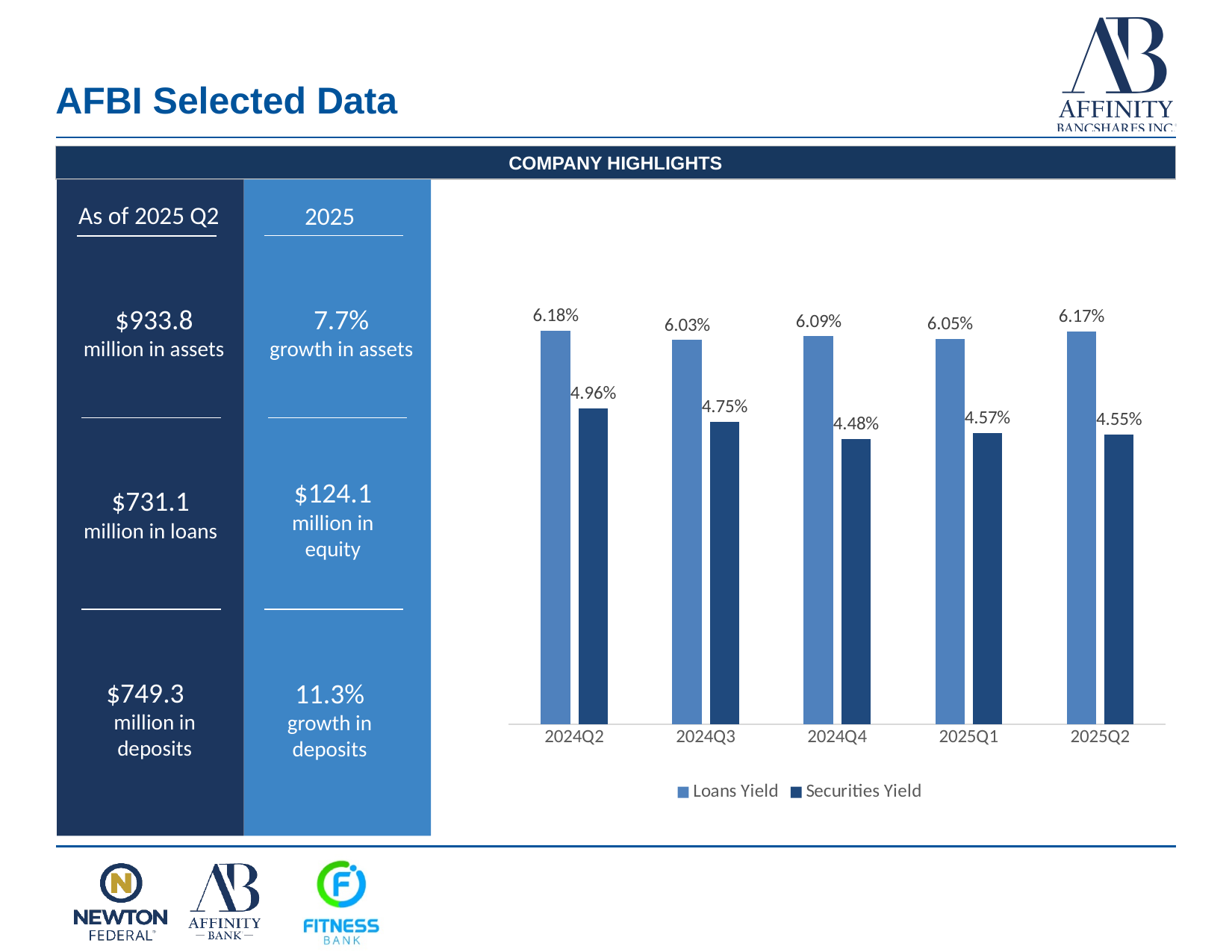
How many series does the chart legend list? 2 Which quarter has the lowest Loans Yield? 2024Q3 What is the difference between the Loans Yield and the Securities Yield in 2025Q2? 1.62% Which quarter has the highest Loans Yield? 2024Q2 What kind of chart is shown on the slide? Bar chart What is the Securities Yield for 2024Q4? 4.48% What is the Loans Yield for 2024Q2? 6.18% How many quarters are shown on the x axis of the chart? 5 Is the Securities Yield higher in 2024Q2 or in 2024Q3? 2024Q2 Which quarter has the lowest Securities Yield? 2024Q4 What is the Securities Yield for 2025Q1? 4.57% What are the two series named in the chart legend? Loans Yield and Securities Yield